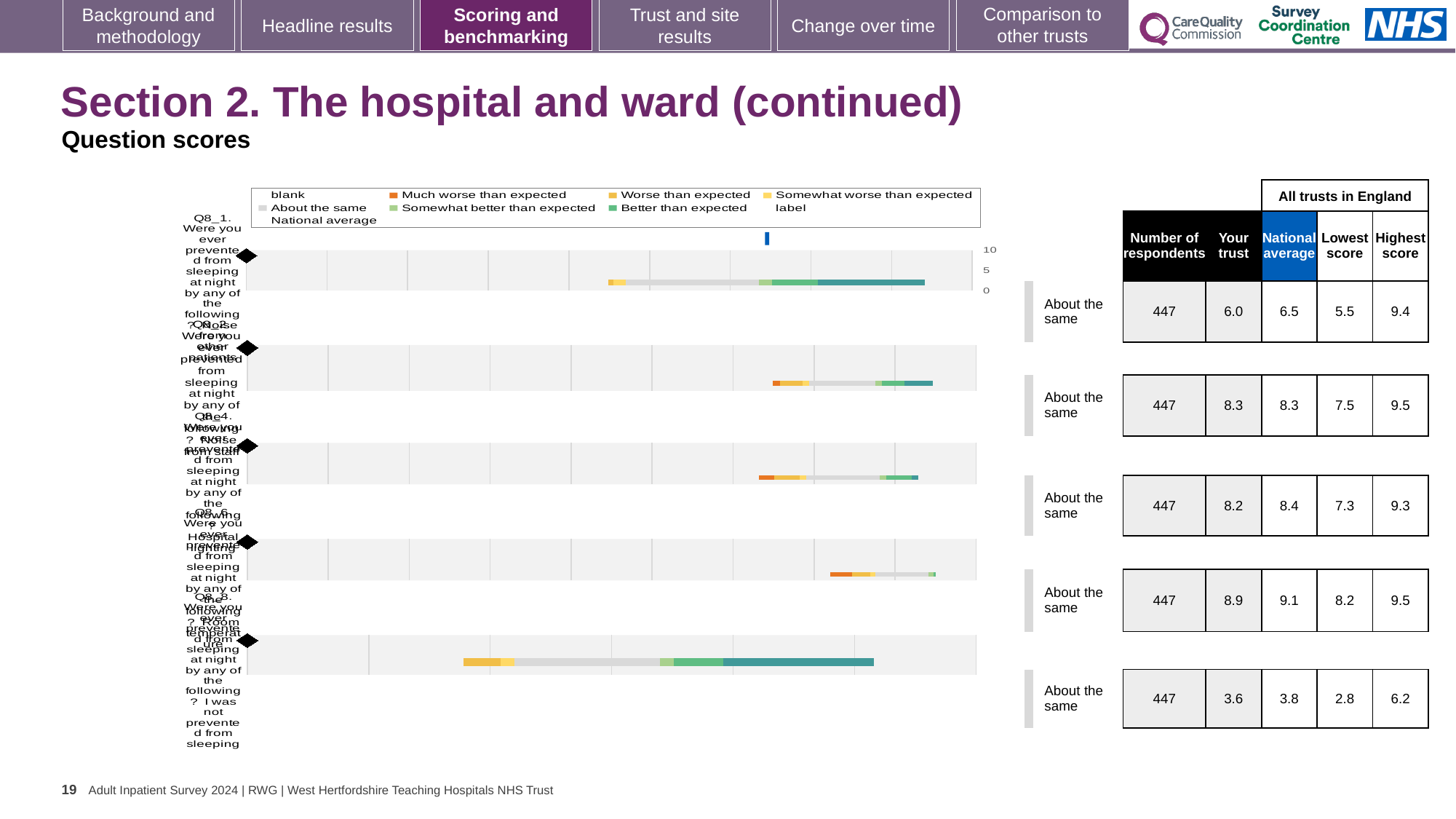
Which question row has the highest 'Your trust' score? Q8_6 What is the lowest score among all trusts in England for Q8_4? 7.3 What is the difference between the national average and the 'Your trust' score for Q8_1? 0.5 What is the 'Your trust' score for the last row, Q8_8? 3.6 What is the national average for the first row, Q8_1? 6.5 What benchmark category is shown for every question row on the slide? About the same How many question rows (bars) are plotted in the chart? 5 For Q8_4, which is larger: the 'Your trust' score or the national average? National average What kind of chart is shown on the slide? bar chart What is the highest score among all trusts in England for Q8_2? 9.5 Which question row has the lowest 'Your trust' score? Q8_8 What is the 'Your trust' score for the first row, Q8_1? 6.0